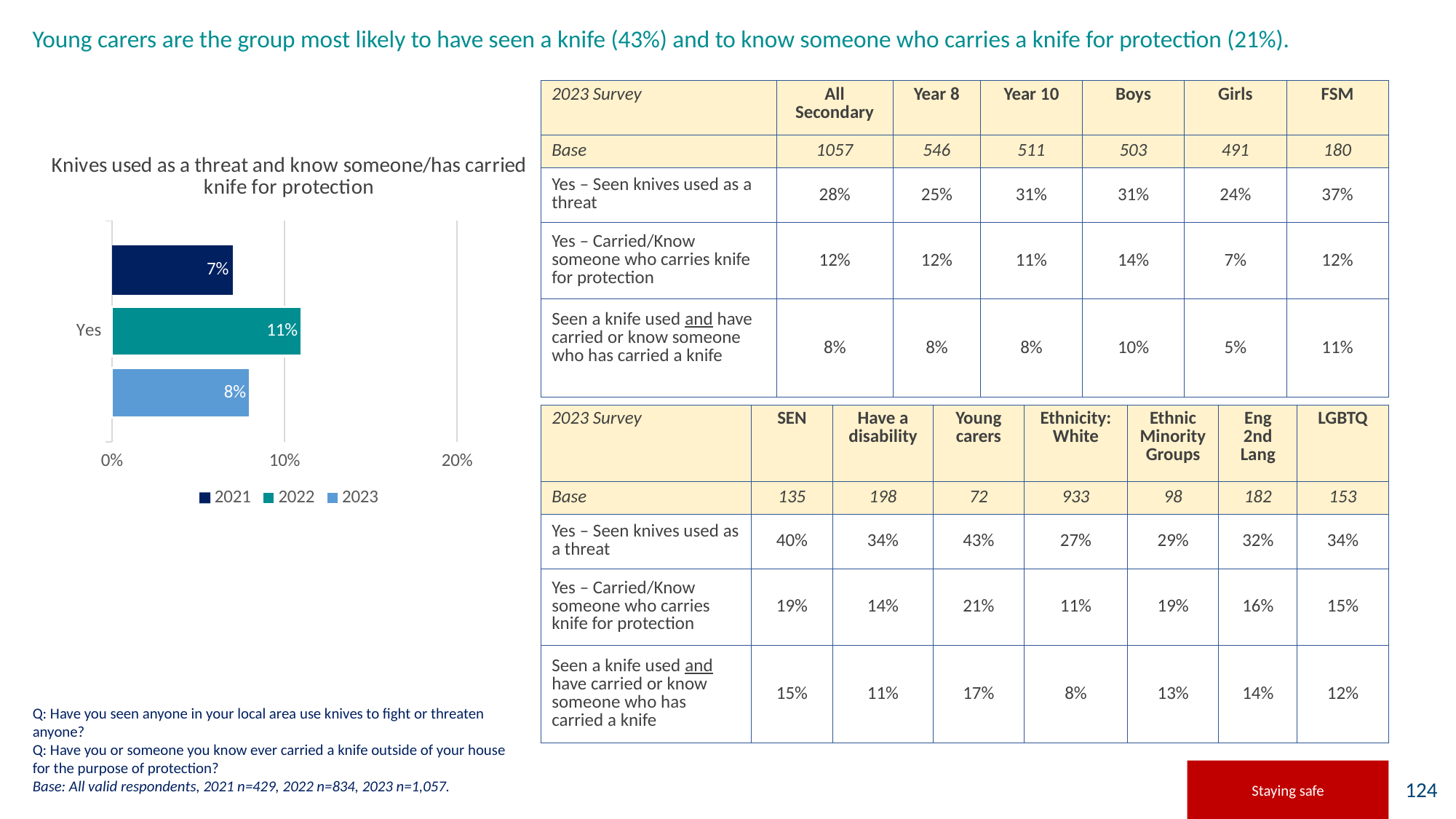
What is the value for 2023 in the chart? 8% What is the difference between the 2022 and 2021 values in the chart? 4% How many series does the chart legend list? 3 Which is larger in the chart, the value for 2021 or the value for 2023? 2023 What is the value for 2021 in the chart? 7% What is the difference between the 2022 and 2023 values in the chart? 3% What kind of chart is shown on the slide? bar chart Is the value for 2022 in the chart greater or less than 10%? greater What is the value for 2022 in the chart? 11% Which year has the lowest value in the chart? 2021 Which year has the highest value in the chart? 2022 What is the title of the chart? Knives used as a threat and know someone/has carried knife for protection